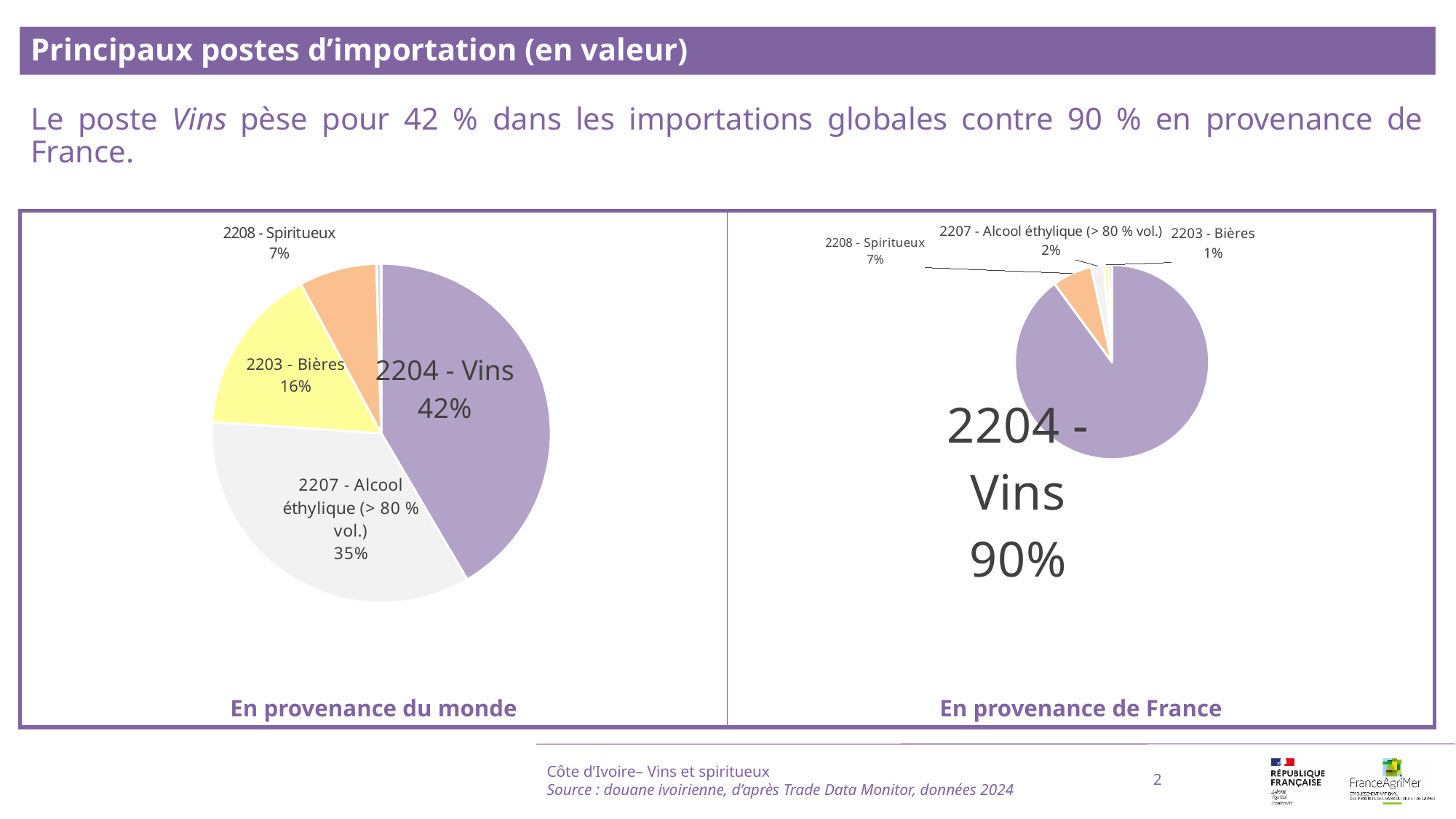
How many labelled categories does the 'En provenance de France' chart show? 4 In the 'En provenance du monde' chart, what is the difference in percentage points between 2204 - Vins and 2207 - Alcool éthylique (> 80 % vol.)? 7 In the 'En provenance du monde' chart, which category has the largest share? 2204 - Vins In the 'En provenance de France' chart, what share does 2208 - Spiritueux have? 7% What kind of chart is 'En provenance de France'? Pie chart In the 'En provenance de France' chart, what share does 2204 - Vins have? 90% In the 'En provenance du monde' chart, what share does 2207 - Alcool éthylique (> 80 % vol.) have? 35% In the 'En provenance du monde' chart, what share does 2203 - Bières have? 16% In the 'En provenance du monde' chart, what share does 2204 - Vins have? 42% In the 'En provenance de France' chart, what share does 2203 - Bières have? 1% In the 'En provenance du monde' chart, which is larger: 2203 - Bières or 2208 - Spiritueux? 2203 - Bières